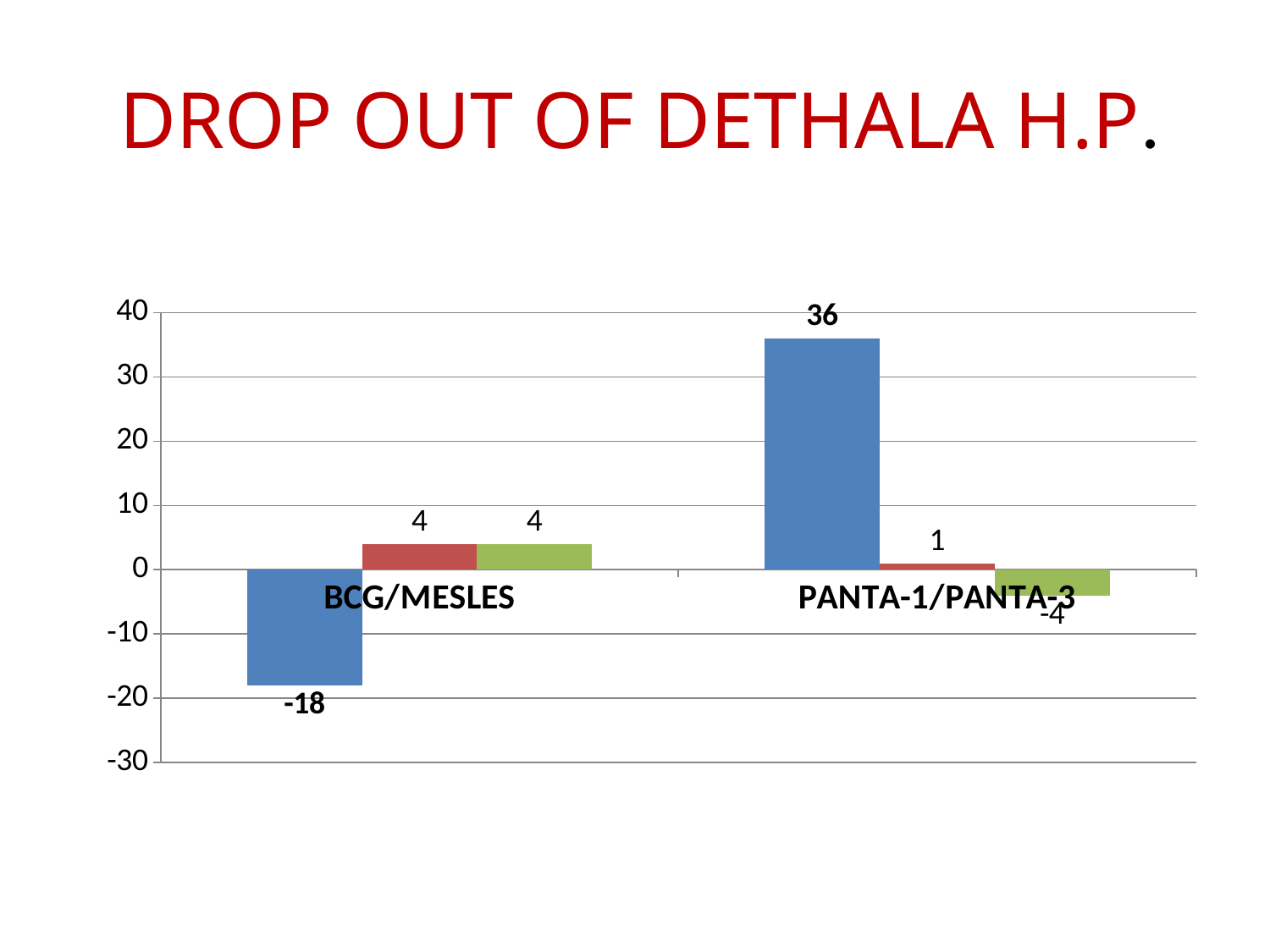
What is the value of the blue bar for PANTA-1/PANTA-3? 36 How many categories are shown on the x axis? 2 What is the difference between the blue bar values for PANTA-1/PANTA-3 and BCG/MESLES? 54 Which bar has the lowest value in the chart? the blue bar for BCG/MESLES (-18) What is the value of the red bar for PANTA-1/PANTA-3? 1 What is the value of the green bar for PANTA-1/PANTA-3? -4 What kind of chart is shown on the slide? bar chart What is the value of the blue bar for BCG/MESLES? -18 Which is larger: the red bar for BCG/MESLES or the red bar for PANTA-1/PANTA-3? BCG/MESLES What is the value of the red bar for BCG/MESLES? 4 What is the title of the slide? DROP OUT OF DETHALA H.P. Which category has the highest blue bar? PANTA-1/PANTA-3